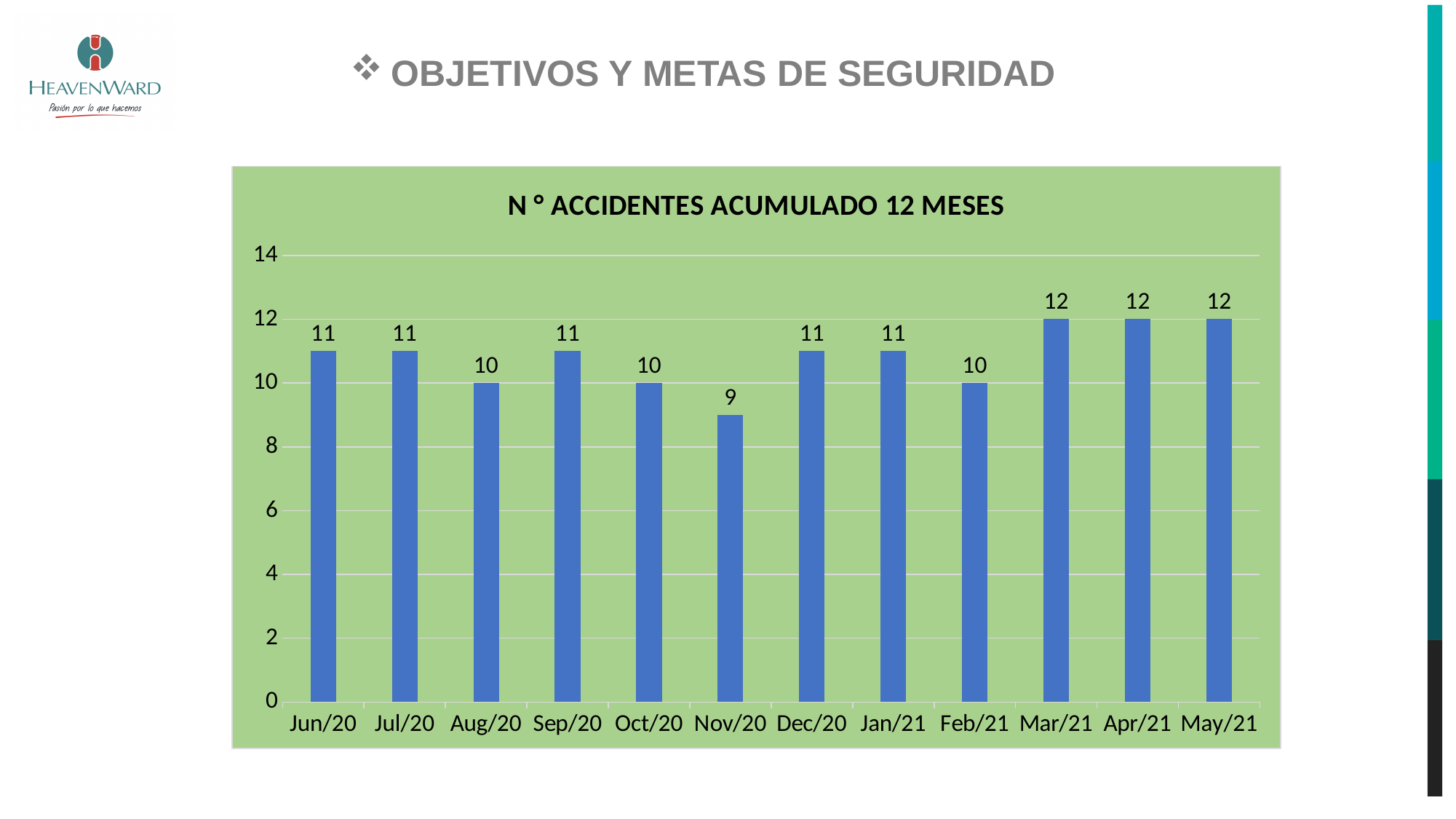
What is the value for Aug/20? 10 What is the difference between the values for Dec/20 and Feb/21? 1 Which month has the lowest value? Nov/20 Which is larger, the value for Jan/21 or the value for Feb/21? Jan/21 How many months are shown on the x axis? 12 What kind of chart is shown on the slide? bar chart What is the value for Nov/20? 9 What is the highest value shown on the y axis? 14 Is the value for Nov/20 greater or less than 10? less What is the difference between the values for May/21 and Nov/20? 3 What is the title of the chart? N ° ACCIDENTES ACUMULADO 12 MESES What is the value for Mar/21? 12